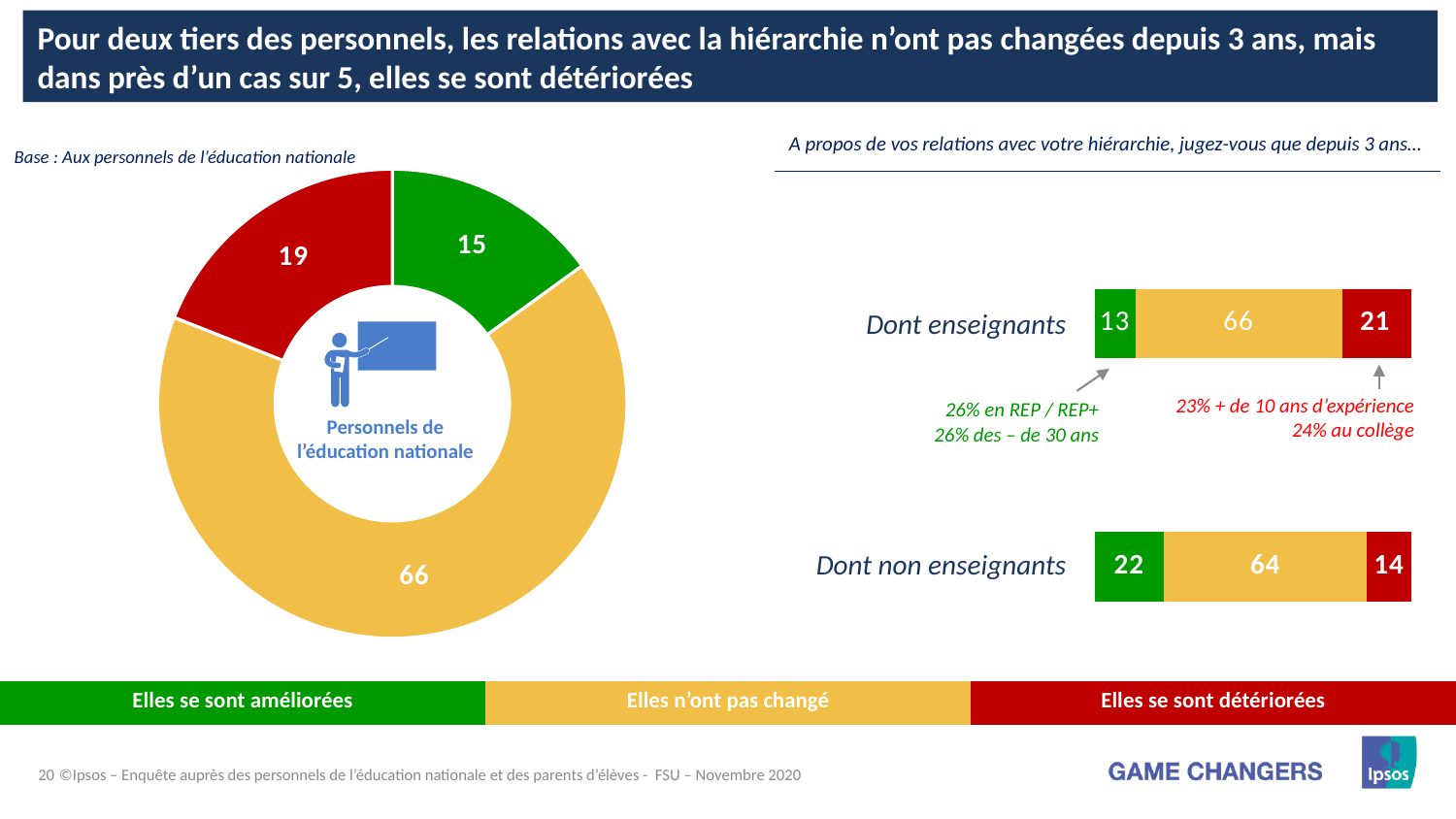
In the donut chart for 'Personnels de l'éducation nationale', what is the difference between 'Elles se sont détériorées' and 'Elles se sont améliorées'? 4 In the donut chart for 'Personnels de l'éducation nationale', what is the value for 'Elles se sont détériorées'? 19 In the donut chart for 'Personnels de l'éducation nationale', which category has the smallest share? Elles se sont améliorées In the 'Dont non enseignants' bar, what is the value for 'Elles n'ont pas changé'? 64 What is the total of the 'Dont non enseignants' stacked bar? 100 Which colour represents 'Elles se sont détériorées' in the charts? Red How many series does the legend at the bottom of the slide list? 3 In the 'Dont enseignants' bar, what is the value for 'Elles se sont détériorées'? 21 In the donut chart for 'Personnels de l'éducation nationale', what is the value for 'Elles n'ont pas changé'? 66 Which is larger: 'Elles se sont améliorées' for 'Dont enseignants' or for 'Dont non enseignants'? Dont non enseignants In the 'Dont enseignants' bar, what is the value for 'Elles se sont améliorées'? 13 What kind of chart is used for 'Personnels de l'éducation nationale'? Donut (pie) chart